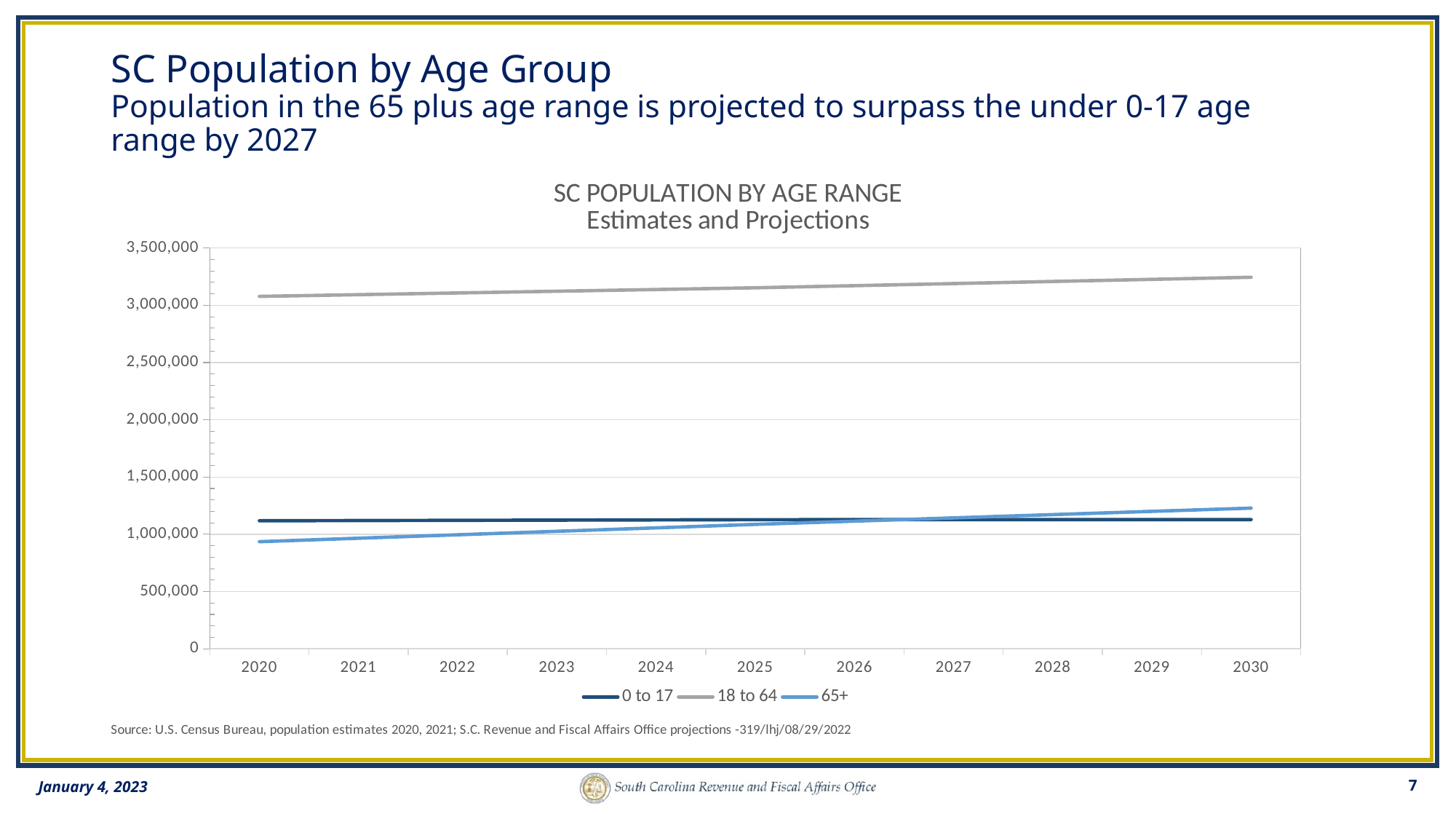
What kind of chart is shown on the slide? Line chart Does the 65+ line rise or fall from 2020 to 2030? Rises What is the title of the chart? SC POPULATION BY AGE RANGE Estimates and Projections Is the value for 65+ in 2020 greater or less than 1,000,000? less In 2020, which is larger: the population for 0 to 17 or for 65+? 0 to 17 In 2030, which is larger: the population for 65+ or for 0 to 17? 65+ How many series does the chart legend list? 3 How many years are shown along the x axis of the chart? 11 Which age group has the highest population in 2030? 18 to 64 Which age group has the lowest population in 2020? 65+ Is the value for 18 to 64 in 2030 greater or less than 3,500,000? less Is the value for 65+ in 2030 greater or less than 1,000,000? greater